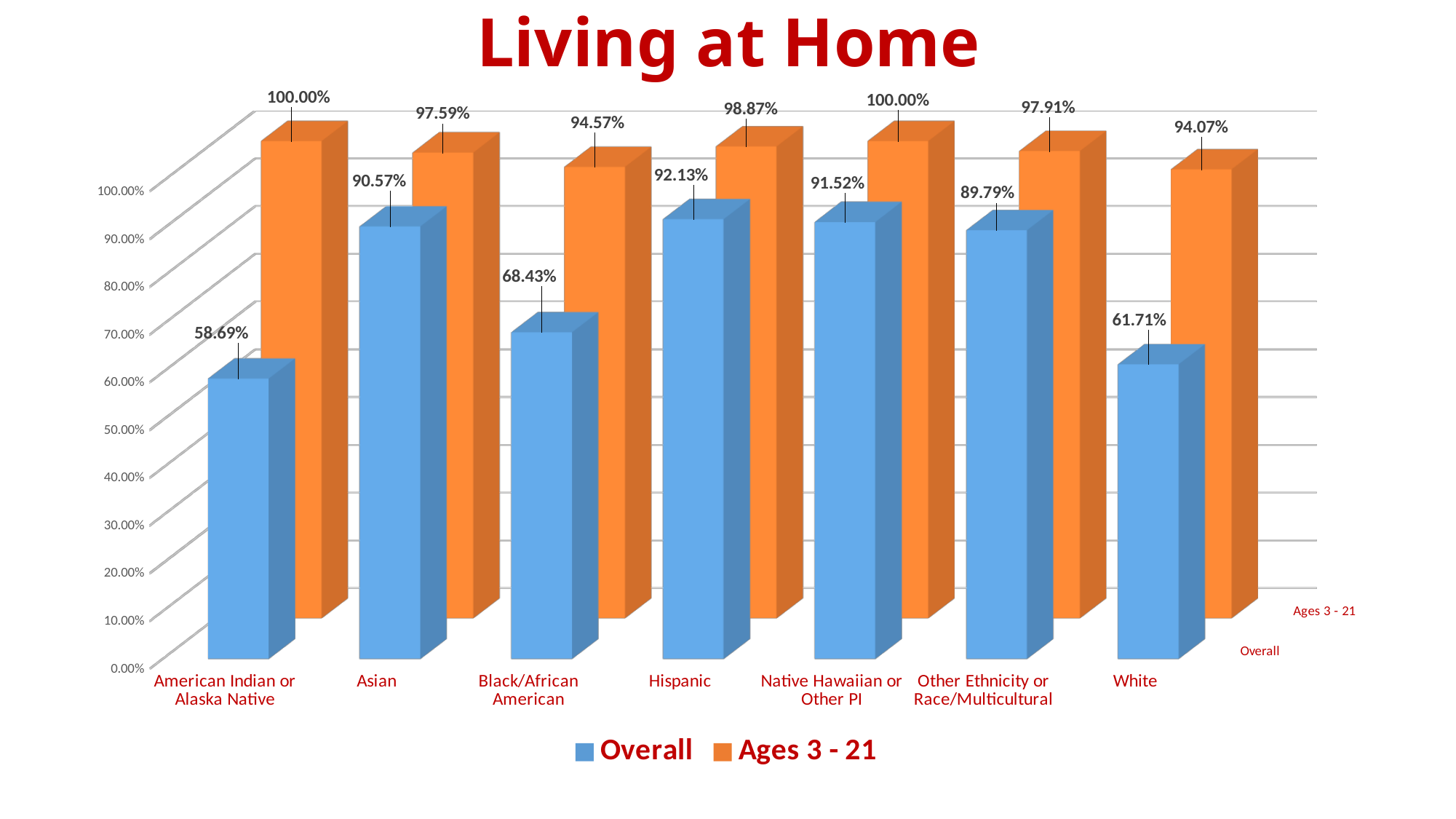
How many series does the legend list? 2 What type of chart is shown on the slide? Bar chart What is the Ages 3 - 21 value for Hispanic? 98.87% What is the difference between the Ages 3 - 21 and Overall values for Black/African American? 26.14% Which category has the lowest Overall value? American Indian or Alaska Native Which category has the lowest Ages 3 - 21 value? White Which category has the highest Overall value? Hispanic What is the Ages 3 - 21 value for Black/African American? 94.57% What is the Overall value for White? 61.71% What is the Overall value for Asian? 90.57% How many categories are shown on the x axis? 7 Which is larger, the Overall value for Native Hawaiian or Other PI or the Overall value for Other Ethnicity or Race/Multicultural? Native Hawaiian or Other PI